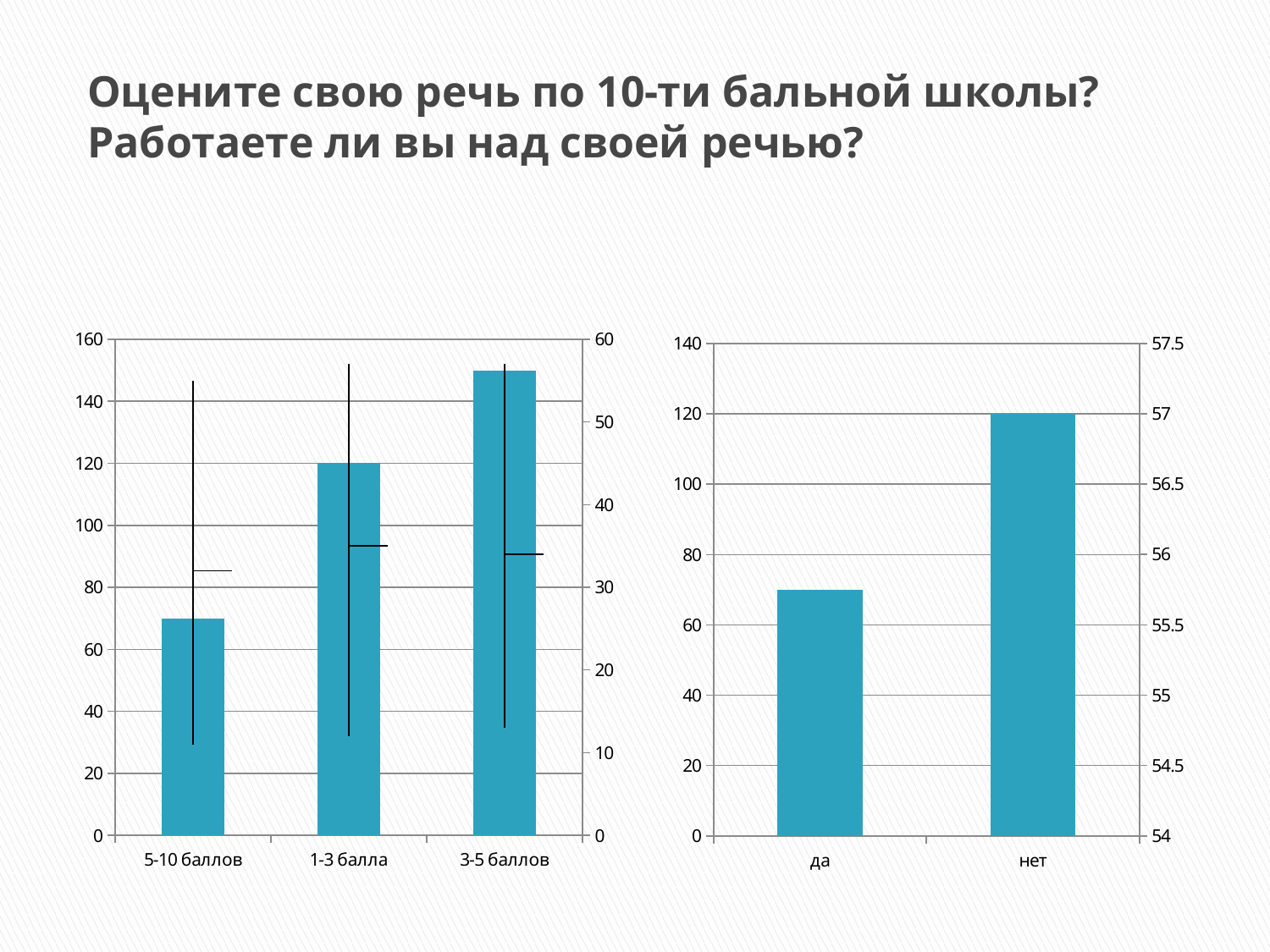
What kind of chart is the left chart? bar chart In the right chart, what is the value for нет? 120 In the left chart, which is larger: the value for 1-3 балла or the value for 5-10 баллов? 1-3 балла In the left chart, what is the value for 1-3 балла? 120 In the left chart, which category has the lowest bar? 5-10 баллов In the left chart, is the value for 3-5 баллов greater or less than 140? greater In the left chart, which category has the highest bar? 3-5 баллов In the right chart, is the value for да greater or less than 80? less In the left chart, is the value for 5-10 баллов greater or less than 100? less How many categories are shown in the left chart? 3 In the right chart, which is larger: да or нет? нет How many categories are shown in the right chart? 2